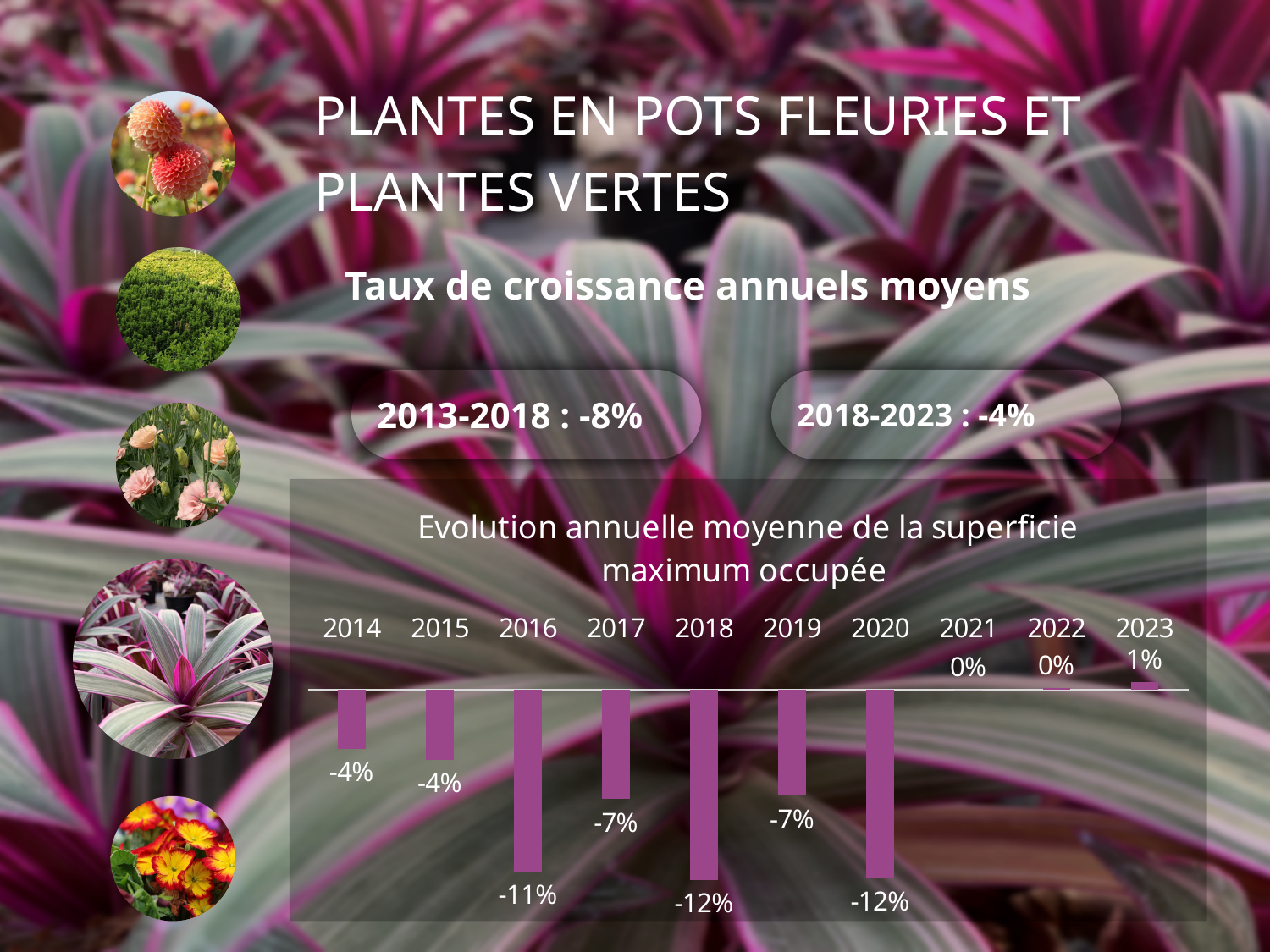
What is the value for 2018 in the chart? -12% What is the title of the chart? Evolution annuelle moyenne de la superficie maximum occupée Which is larger, the value for 2014 or the value for 2020? 2014 How many years are shown on the x axis of the chart? 10 What is the difference between the values for 2017 and 2016? 4 percentage points What is the value for 2019 in the chart? -7% Do the values rise or fall from 2020 to 2023? Rise What is the value for 2021 in the chart? 0% What is the value for 2023 in the chart? 1% What kind of chart is shown on the slide? Bar chart What is the value for 2016 in the chart? -11% Which year has the highest value in the chart? 2023